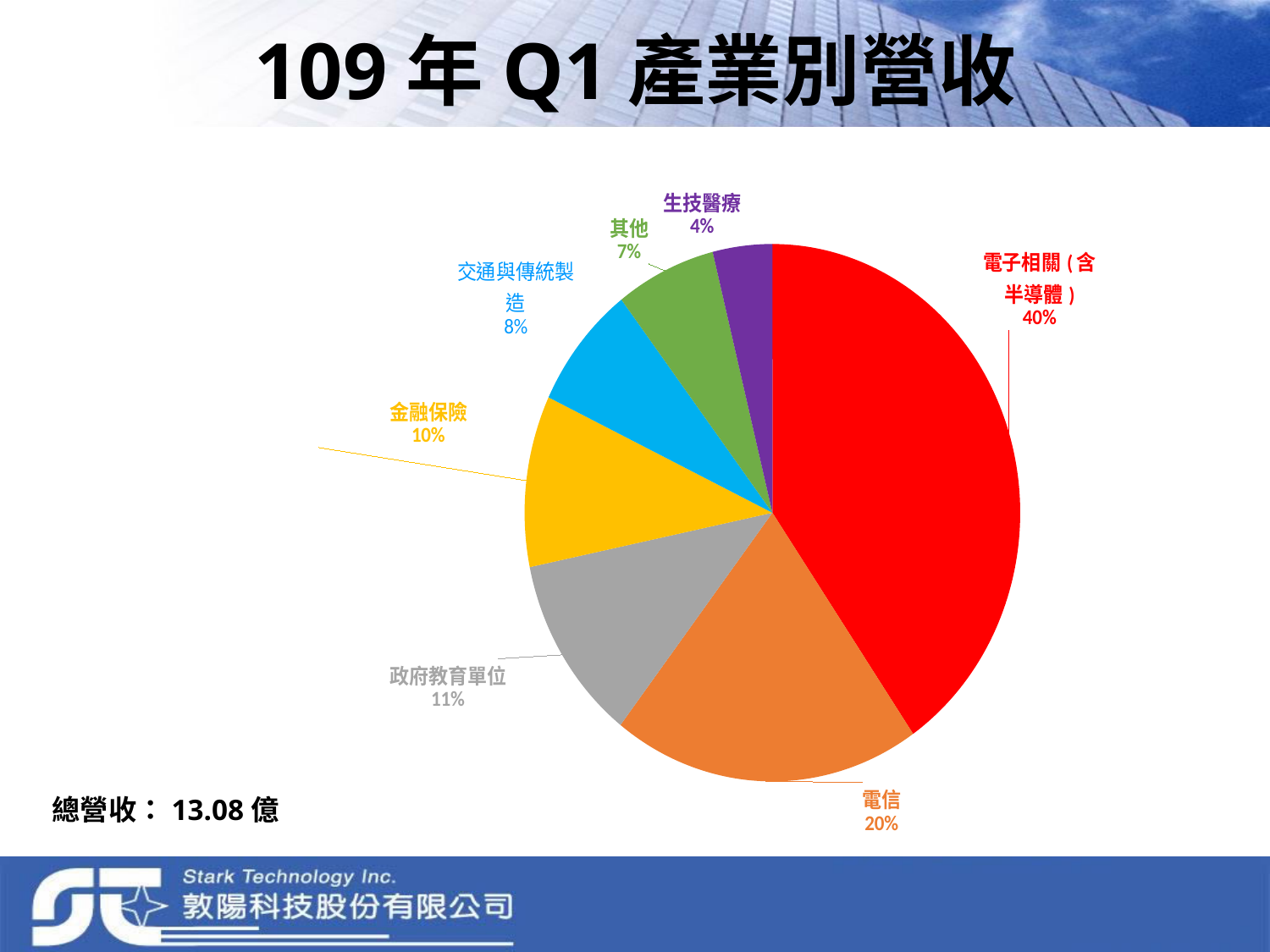
What is the value shown for 政府教育單位? 11% Which category has the largest slice of the pie? 電子相關(含半導體) What is the value shown for 生技醫療? 4% How many slices does the pie chart have? 7 What share of the pie does 電信 hold? 20% What kind of chart is shown on the slide? pie chart What is the value shown for 金融保險? 10% What share of the pie does 電子相關(含半導體) hold? 40% Which is larger, the slice for 其他 or the slice for 生技醫療? 其他 What is the difference in percentage points between 電子相關(含半導體) and 電信? 20 What is the value shown for 交通與傳統製造? 8% Which category has the smallest slice of the pie? 生技醫療